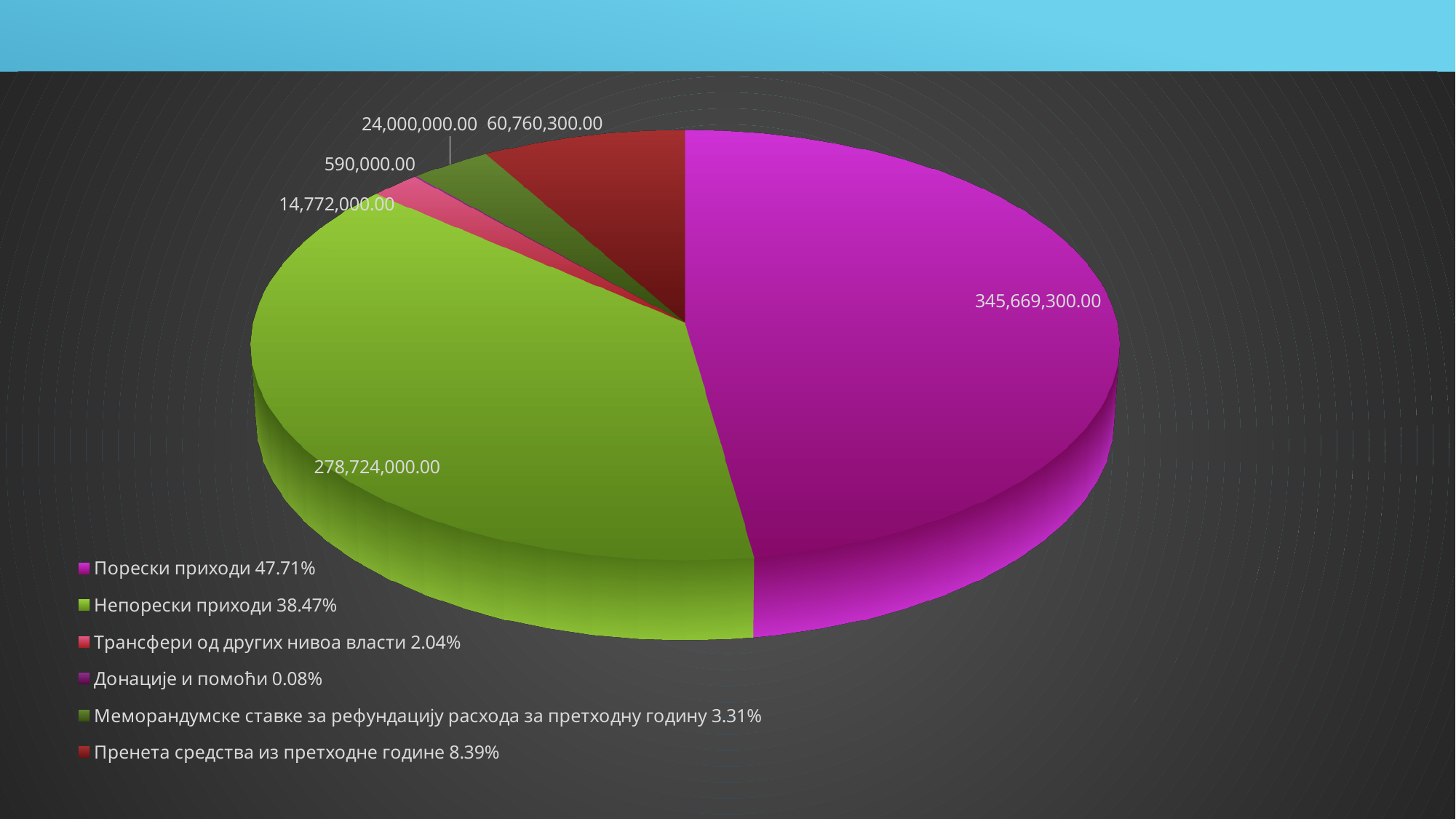
What kind of chart is shown on the slide? Pie chart What is the value shown for Трансфери од других нивоа власти? 14,772,000.00 What share of the pie does Меморандумске ставке за рефундацију расхода за претходну годину represent? 3.31% Which category has the largest slice of the pie? Порески приходи How many slices does the pie chart have? 6 What is the value shown for Пренета средства из претходне године? 60,760,300.00 What share of the pie does Непорески приходи represent? 38.47% What is the value shown for Непорески приходи? 278,724,000.00 Which category has the smallest slice of the pie? Донације и помоћи Which is larger: the value for Пренета средства из претходне године or the value for Меморандумске ставке за рефундацију расхода за претходну годину? Пренета средства из претходне године What is the value shown for Порески приходи? 345,669,300.00 What is the difference between the values for Порески приходи and Непорески приходи? 66,945,300.00